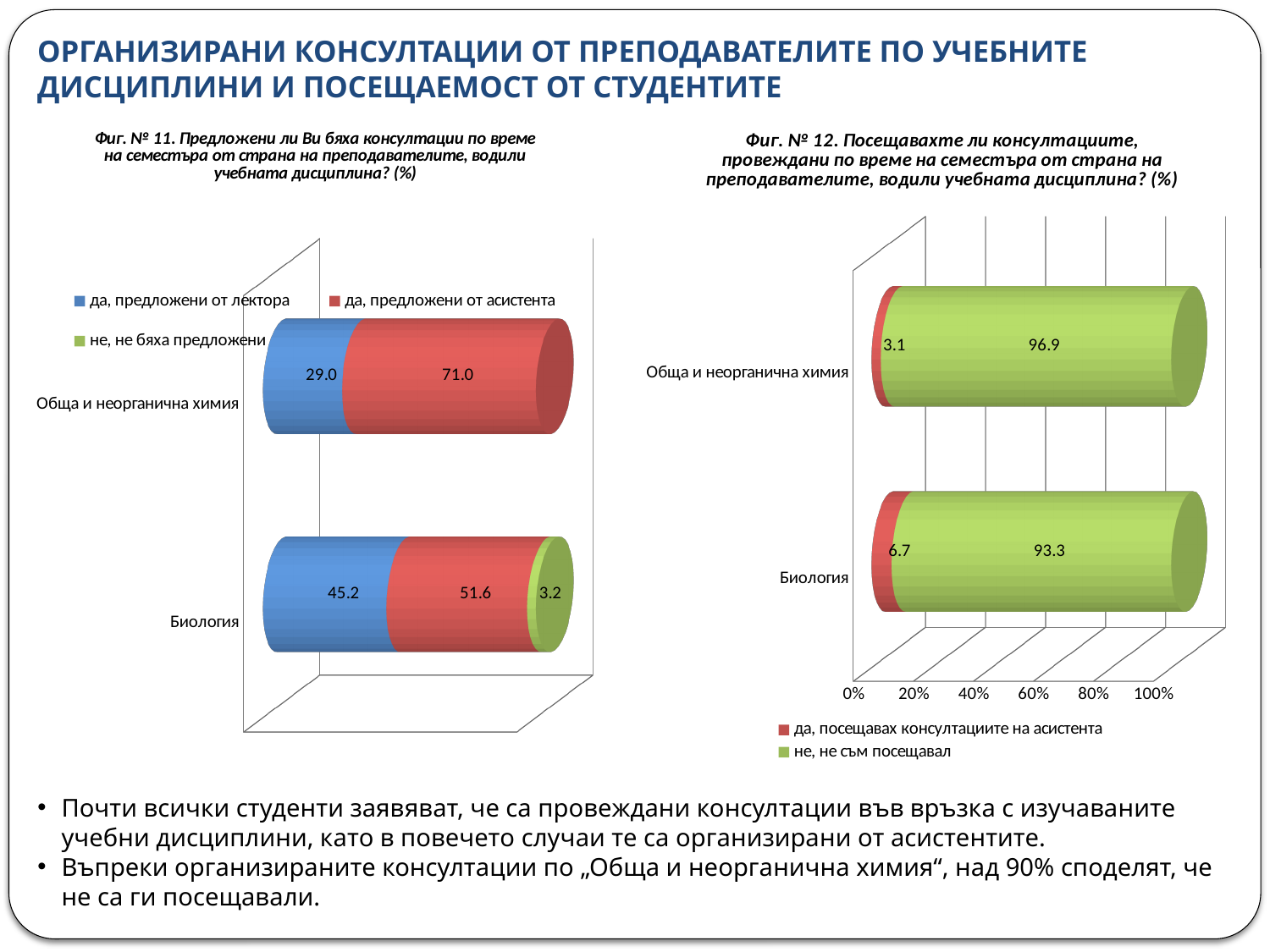
In Фиг. № 11 (left chart), what is the value for 'да, предложени от асистента' for Биология? 51.6 In Фиг. № 11 (left chart), what is the value for 'не, не бяха предложени' for Биология? 3.2 In Фиг. № 11 (left chart), which is larger for Биология: 'да, предложени от лектора' or 'да, предложени от асистента'? да, предложени от асистента What kind of chart is Фиг. № 12 (right chart)? Stacked bar chart In Фиг. № 12 (right chart), what is the total of the stacked bar for Биология? 100.0 In Фиг. № 12 (right chart), what is the value for 'да, посещавах консултациите на асистента' for Биология? 6.7 In Фиг. № 11 (left chart), what is the value for 'да, предложени от лектора' for Обща и неорганична химия? 29.0 How many series does the legend of Фиг. № 12 (right chart) list? 2 How many series does the legend of Фиг. № 11 (left chart) list? 3 In Фиг. № 12 (right chart), which category has the higher value for 'не, не съм посещавал'? Обща и неорганична химия In Фиг. № 12 (right chart), what is the value for 'не, не съм посещавал' for Обща и неорганична химия? 96.9 In Фиг. № 11 (left chart), what is the difference between the 'да, предложени от асистента' values for Обща и неорганична химия and Биология? 19.4